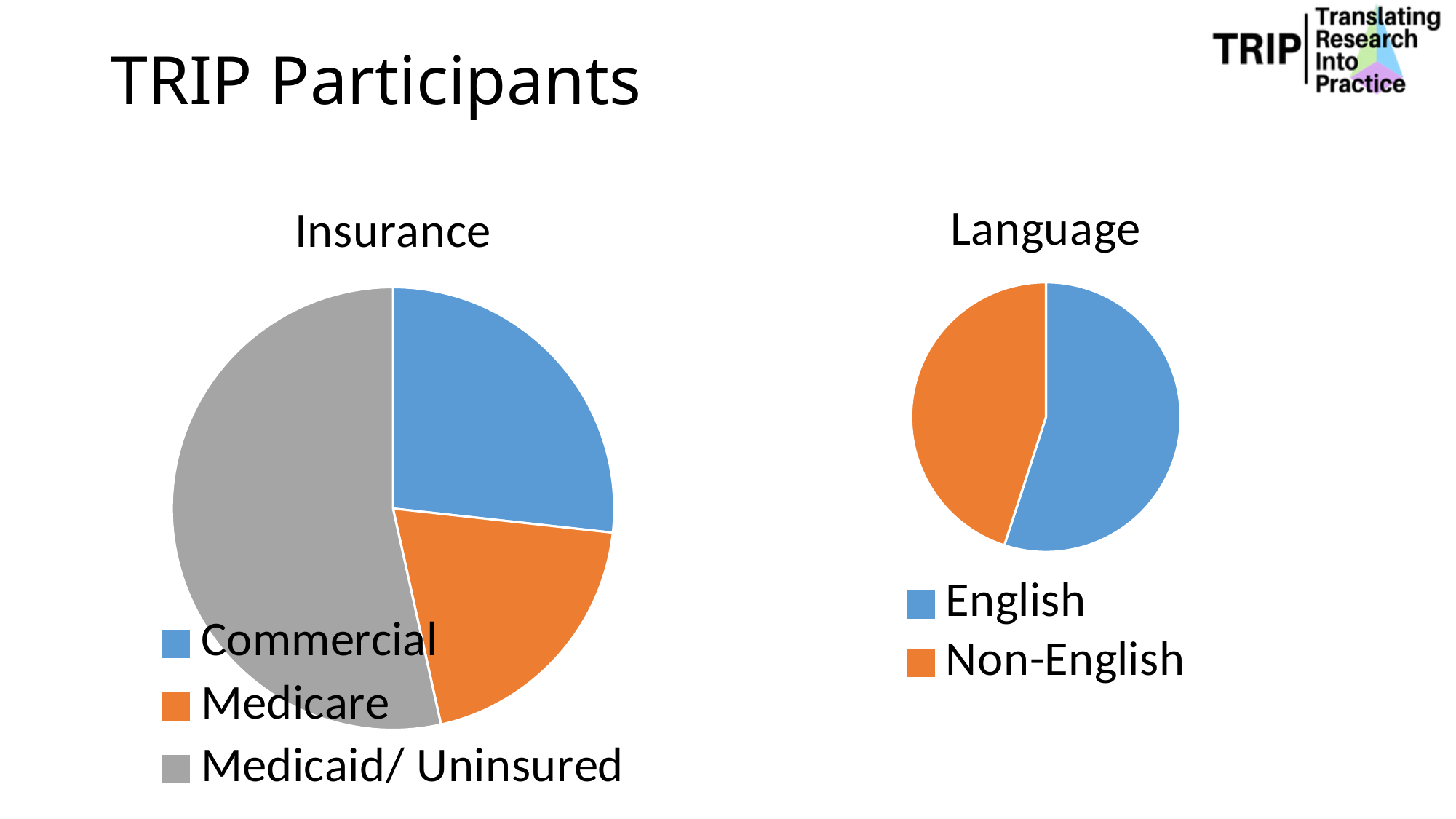
In the Language chart, which is larger, English or Non-English? English In the Language chart, how many categories are shown? 2 What kind of chart is the Language chart? pie chart In the Language chart, which category has the largest slice? English In the Insurance chart, what colour is the Medicaid/ Uninsured slice? grey What kind of chart is the Insurance chart? pie chart In the Insurance chart, which is larger, Medicaid/ Uninsured or Commercial? Medicaid/ Uninsured In the Language chart, what colour is the Non-English slice? orange In the Insurance chart, which is larger, Commercial or Medicare? Commercial In the Insurance chart, which category has the largest slice? Medicaid/ Uninsured In the Insurance chart, which category has the smallest slice? Medicare In the Insurance chart, how many categories are shown? 3